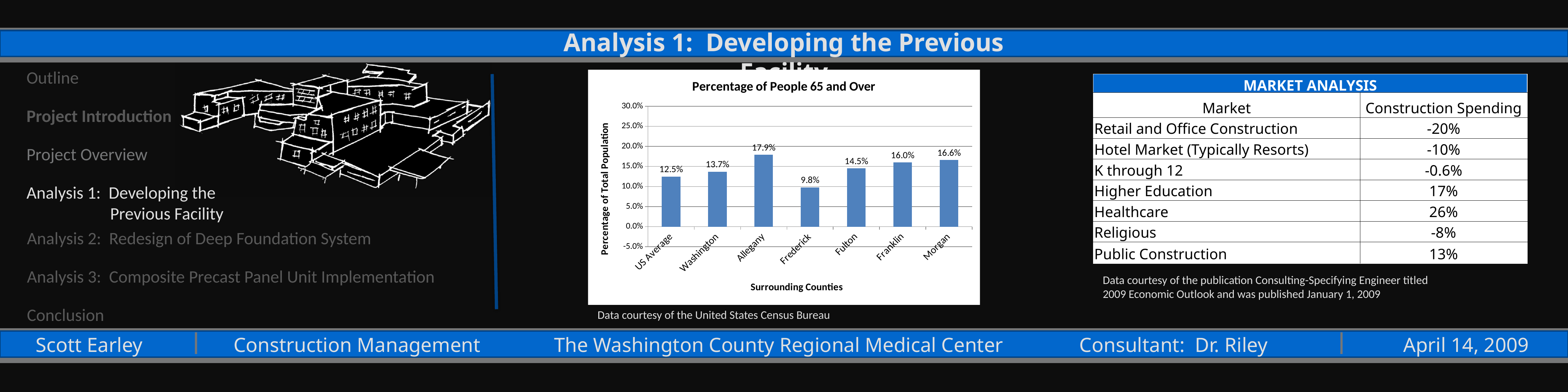
In the 'Percentage of People 65 and Over' chart, which is larger, the value for Fulton or the value for Franklin? Franklin What is the value for US Average in the 'Percentage of People 65 and Over' chart? 12.5% What is the difference between the values for Morgan and Washington in the 'Percentage of People 65 and Over' chart? 2.9% Is the value for Allegany in the 'Percentage of People 65 and Over' chart greater or less than 15.0%? greater Which county has the lowest percentage of people 65 and over in the chart? Frederick What is the y-axis title of the 'Percentage of People 65 and Over' chart? Percentage of Total Population How many categories are shown on the x axis of the 'Percentage of People 65 and Over' chart? 7 What kind of chart is 'Percentage of People 65 and Over'? Bar chart Which county has the highest percentage of people 65 and over in the chart? Allegany What is the value for Allegany in the 'Percentage of People 65 and Over' chart? 17.9% What is the x-axis title of the 'Percentage of People 65 and Over' chart? Surrounding Counties What is the value for Frederick in the 'Percentage of People 65 and Over' chart? 9.8%